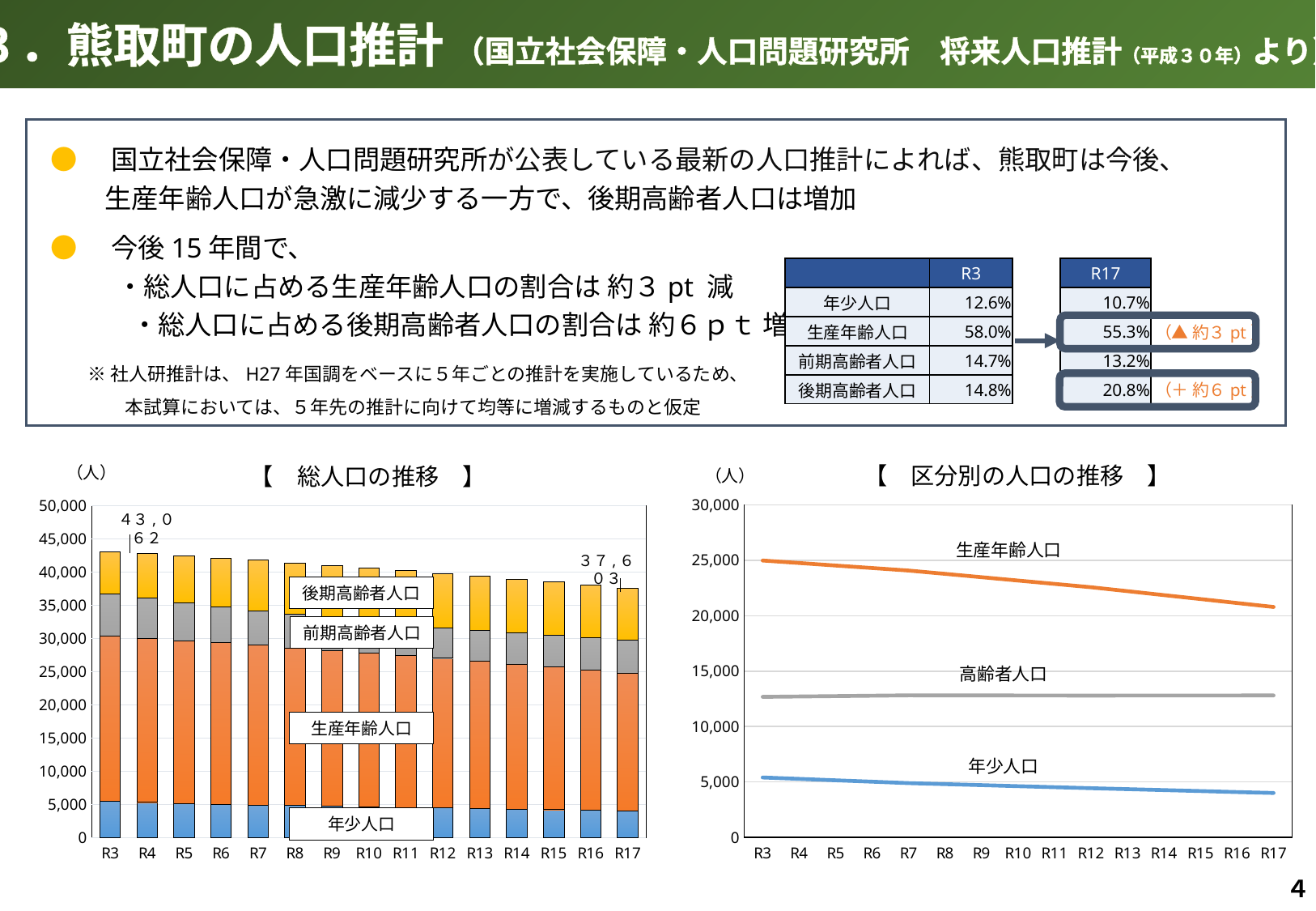
In the 区分別の人口の推移 chart, is the value of 生産年齢人口 at R17 greater or less than 20,000? greater What kind of chart is the 区分別の人口の推移 chart on the right? line chart In the 区分別の人口の推移 chart, does 生産年齢人口 rise or fall from R3 to R17? fall In the 総人口の推移 chart, what is the total population shown for R17? 37,603 In the 総人口の推移 chart, what is the total population shown for R3? 43,062 How many years (categories) are shown on the x axis of the 総人口の推移 chart? 15 In the 総人口の推移 chart, is the total for R17 greater or less than 40,000? less How many series are plotted in the 区分別の人口の推移 chart? 3 In the 区分別の人口の推移 chart, which series has the highest values? 生産年齢人口 In the 総人口の推移 chart, by how much does the total population fall from R3 to R17? 5,459 In the 総人口の推移 chart, does the total population rise or fall from R3 to R17? fall What kind of chart is the 総人口の推移 chart on the left? stacked bar chart